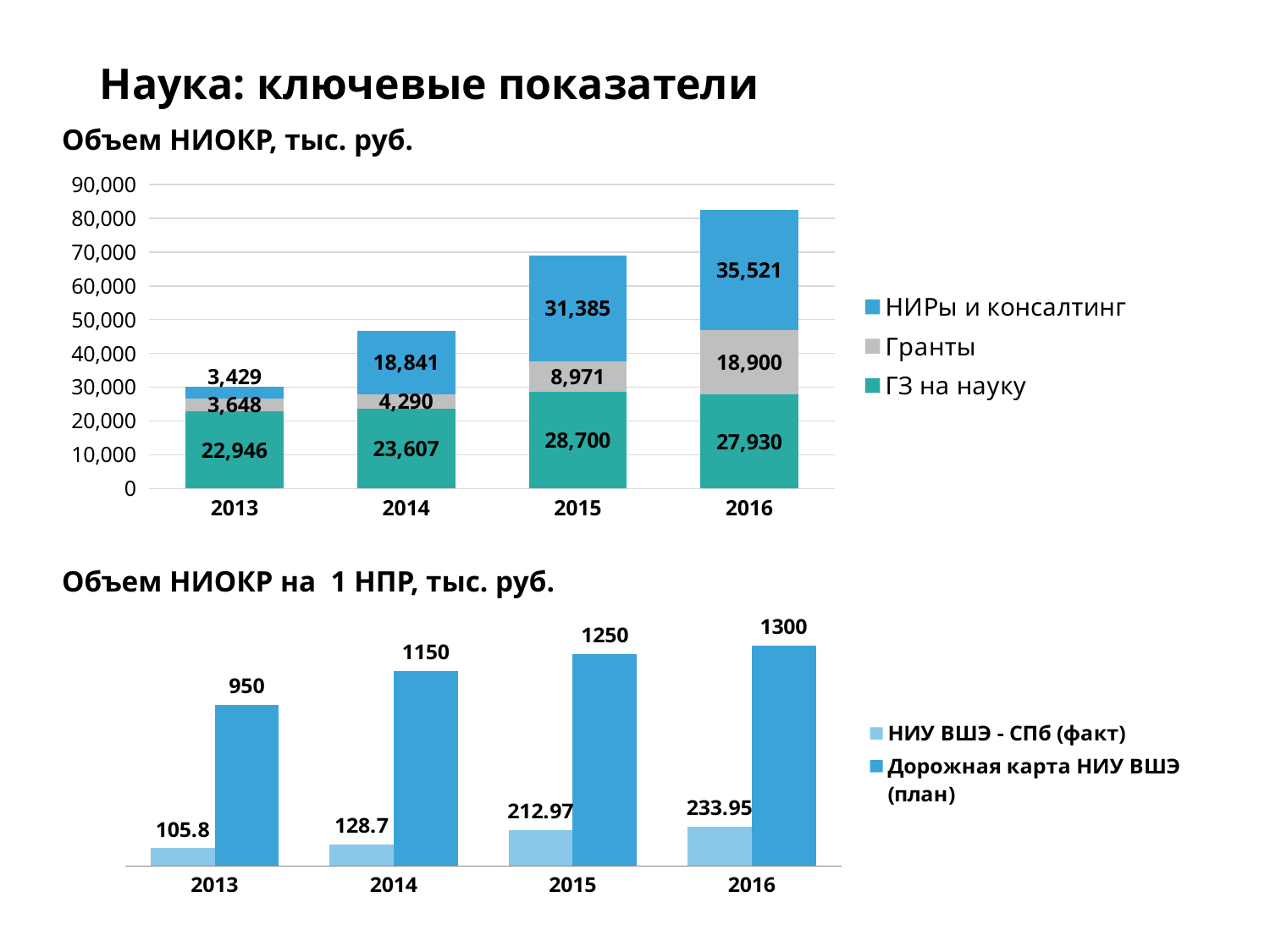
In the chart 'Объем НИОКР, тыс. руб.', what is the value of 'Гранты' for 2016? 18,900 In the chart 'Объем НИОКР, тыс. руб.', which year has the lowest value for 'Гранты'? 2013 In the chart 'Объем НИОКР, тыс. руб.', what is the value of 'ГЗ на науку' for 2015? 28,700 In the chart 'Объем НИОКР на 1 НПР, тыс. руб.', do the values for 'НИУ ВШЭ - СПб (факт)' rise or fall from 2013 to 2016? Rise In the chart 'Объем НИОКР на 1 НПР, тыс. руб.', what is the difference between 'Дорожная карта НИУ ВШЭ (план)' and 'НИУ ВШЭ - СПб (факт)' in 2016? 1066.05 What kind of chart is 'Объем НИОКР, тыс. руб.'? Stacked bar chart In the chart 'Объем НИОКР, тыс. руб.', what is the total of the stacked bar for 2016? 82,351 In the chart 'Объем НИОКР, тыс. руб.', what is the difference between 'НИРы и консалтинг' in 2015 and in 2014? 12,544 In the chart 'Объем НИОКР, тыс. руб.', how many series does the legend list? 3 In the chart 'Объем НИОКР, тыс. руб.', which year has the highest value for 'НИРы и консалтинг'? 2016 In the chart 'Объем НИОКР на 1 НПР, тыс. руб.', what is the value of 'НИУ ВШЭ - СПб (факт)' for 2015? 212.97 In the chart 'Объем НИОКР на 1 НПР, тыс. руб.', how many years are shown on the x axis? 4